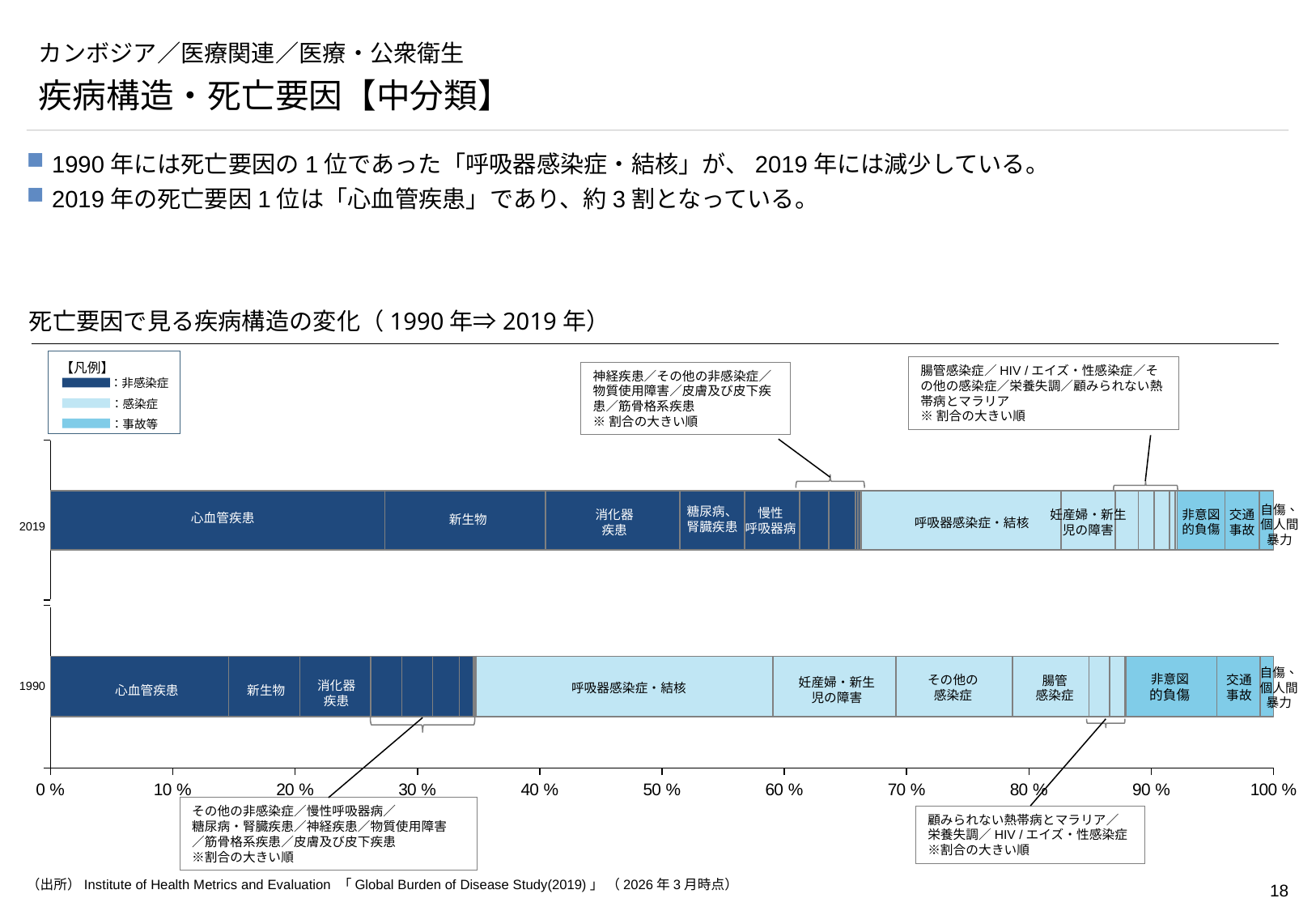
Which year has the larger share of 心血管疾患, 2019 or 1990? 2019 Is the share of 呼吸器感染症・結核 in 2019 greater or less than 20%? less How many years (bars) are plotted in the chart? 2 Which year has the larger share of 呼吸器感染症・結核, 2019 or 1990? 1990 How many categories does the legend (【凡例】) list? 3 What kind of chart is shown on the slide? bar chart Is the share of 心血管疾患 in 2019 greater or less than 20%? greater Is the share of 呼吸器感染症・結核 in 1990 greater or less than 20%? greater Which cause of death has the largest segment in the 1990 bar? 呼吸器感染症・結核 Which cause of death has the largest segment in the 2019 bar? 心血管疾患 What is the title of the chart? 死亡要因で見る疾病構造の変化（1990年⇒2019年）